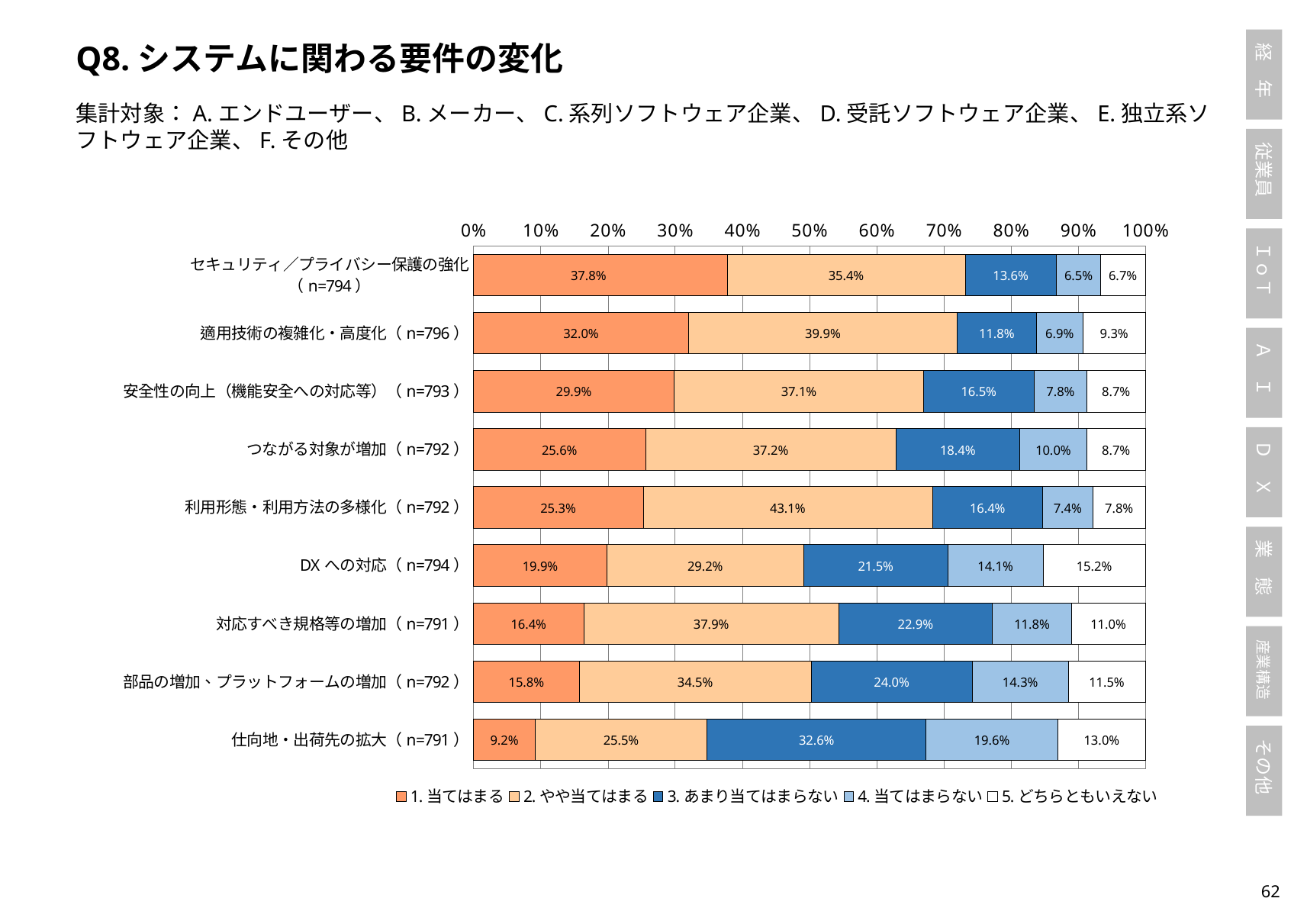
What is the value of "1. 当てはまる" for セキュリティ／プライバシー保護の強化? 37.8% What is the sample size (n) shown for 適用技術の複雑化・高度化? 796 Which is larger: the "4. 当てはまらない" value for 仕向地・出荷先の拡大 or for 部品の増加、プラットフォームの増加? 仕向地・出荷先の拡大 Which category has the lowest value for "1. 当てはまる"? 仕向地・出荷先の拡大 How many categories (rows) are plotted in the chart? 9 What is the value of "3. あまり当てはまらない" for 仕向地・出荷先の拡大? 32.6% What is the difference between the "1. 当てはまる" values for 適用技術の複雑化・高度化 and つながる対象が増加? 6.4% What is the value of "2. やや当てはまる" for 利用形態・利用方法の多様化? 43.1% Which category has the highest value for "1. 当てはまる"? セキュリティ／プライバシー保護の強化 What is the value of "5. どちらともいえない" for DX への対応? 15.2% How many series does the legend list? 5 What type of chart is shown on the slide? Stacked bar chart